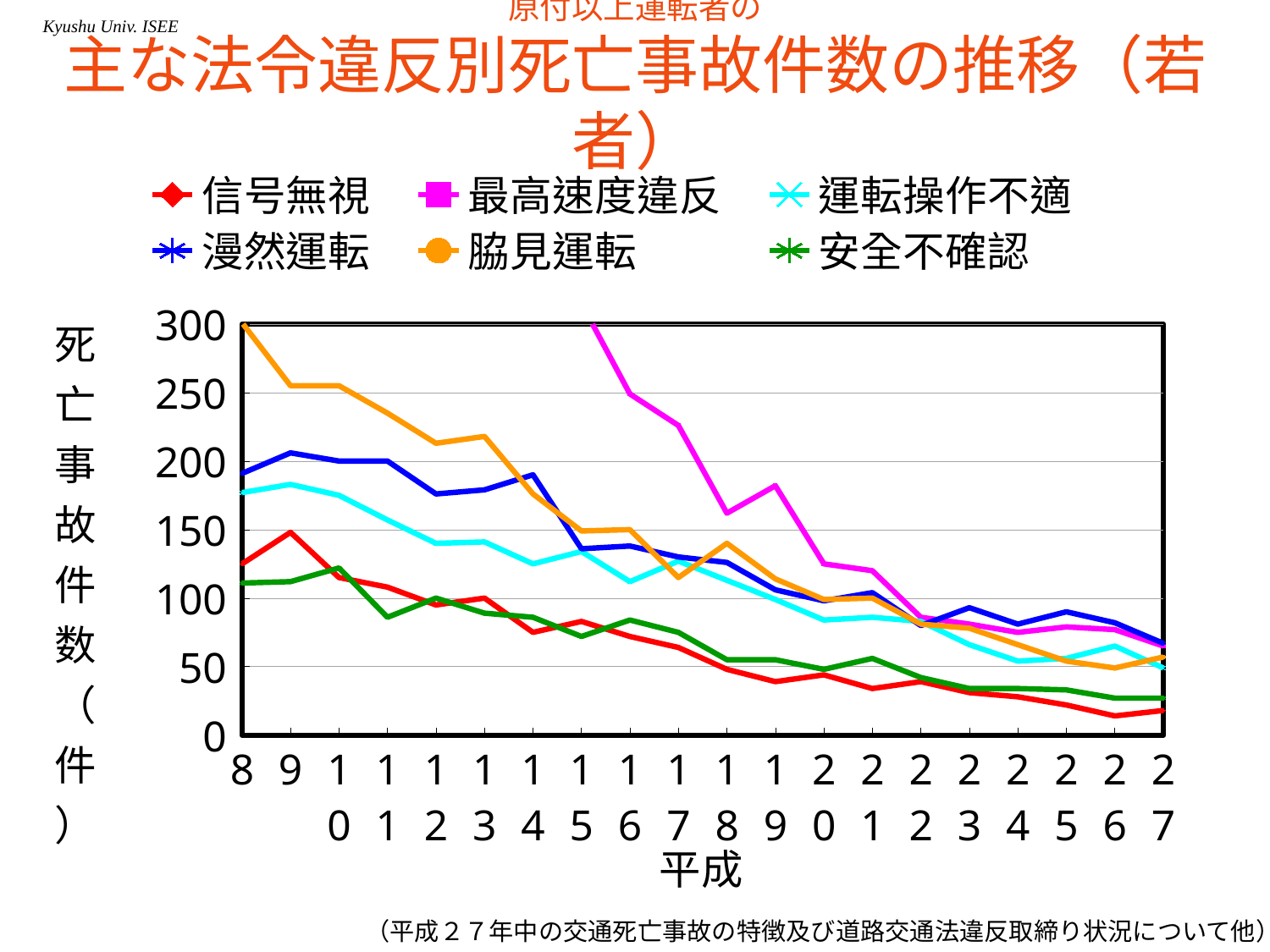
At 平成16, which is larger: 最高速度違反 or 漫然運転? 最高速度違反 Does the 脇見運転 series generally rise or fall from 平成8 to 平成27? fall How many years (points) are shown along the x axis? 20 What kind of chart is shown on the slide? line chart Is the value for 信号無視 at 平成26 greater or less than 50? less Is the value for 脇見運転 at 平成8 greater or less than 250? greater Which series has the lowest value at 平成27? 信号無視 What is the label of the x axis? 平成 Is the value for 漫然運転 at 平成12 greater or less than 200? less At 平成8, which is larger: 脇見運転 or 信号無視? 脇見運転 How many series does the legend list? 6